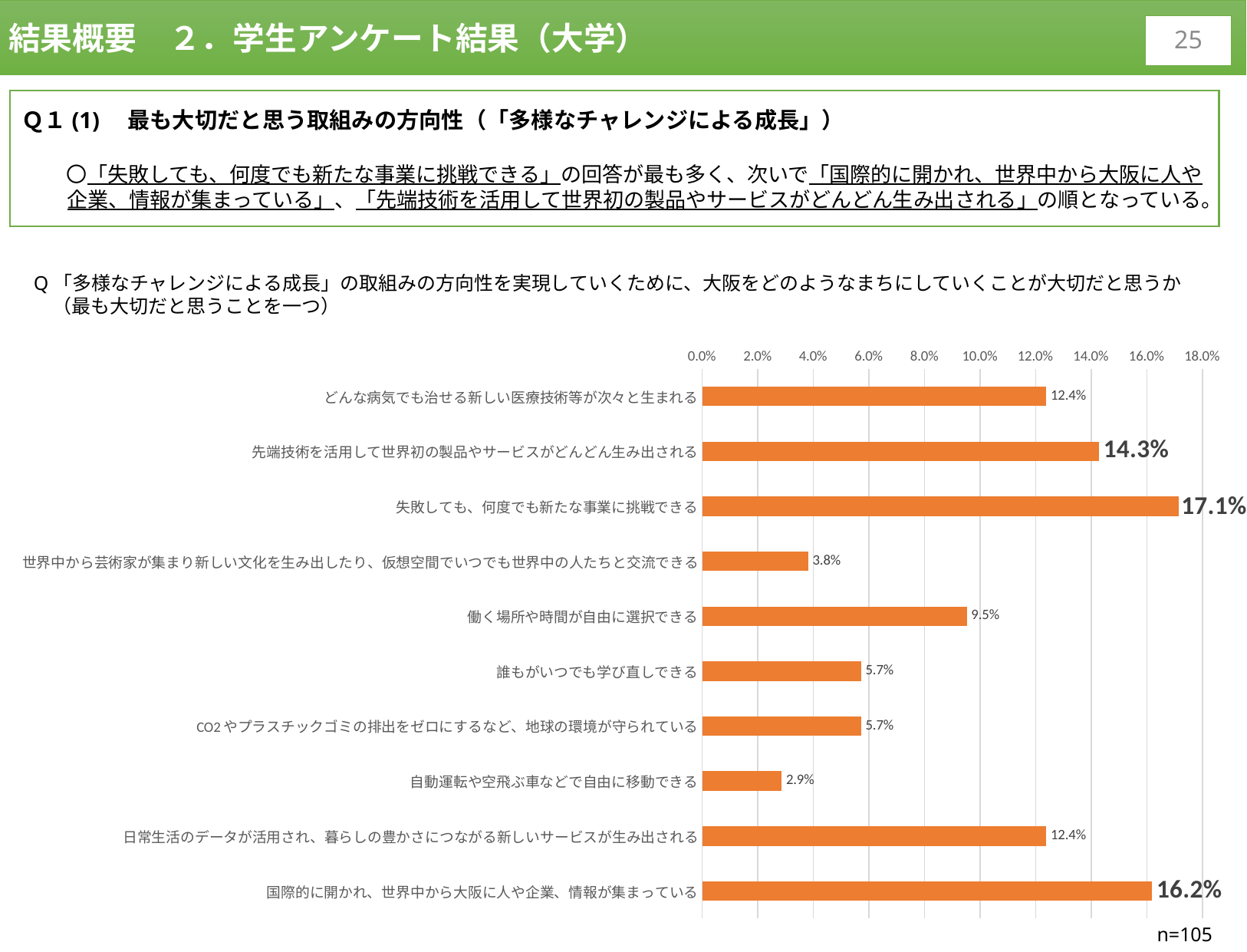
Is the value for 「世界中から芸術家が集まり新しい文化を生み出したり、仮想空間でいつでも世界中の人たちと交流できる」 greater or less than 4.0%? less Which category has the highest value? 失敗しても、何度でも新たな事業に挑戦できる What is the value for 「失敗しても、何度でも新たな事業に挑戦できる」? 17.1% How many categories are shown in the bar chart? 10 What is the value for 「自動運転や空飛ぶ車などで自由に移動できる」? 2.9% What is the maximum value shown on the horizontal axis? 18.0% What is the difference between 「失敗しても、何度でも新たな事業に挑戦できる」 and 「国際的に開かれ、世界中から大阪に人や企業、情報が集まっている」? 0.9% What kind of chart is shown on the slide? bar chart What is the sample size (n) shown for the chart? n=105 Which category has the lowest value? 自動運転や空飛ぶ車などで自由に移動できる Which is larger: 「先端技術を活用して世界初の製品やサービスがどんどん生み出される」 or 「日常生活のデータが活用され、暮らしの豊かさにつながる新しいサービスが生み出される」? 先端技術を活用して世界初の製品やサービスがどんどん生み出される What is the value for 「働く場所や時間が自由に選択できる」? 9.5%